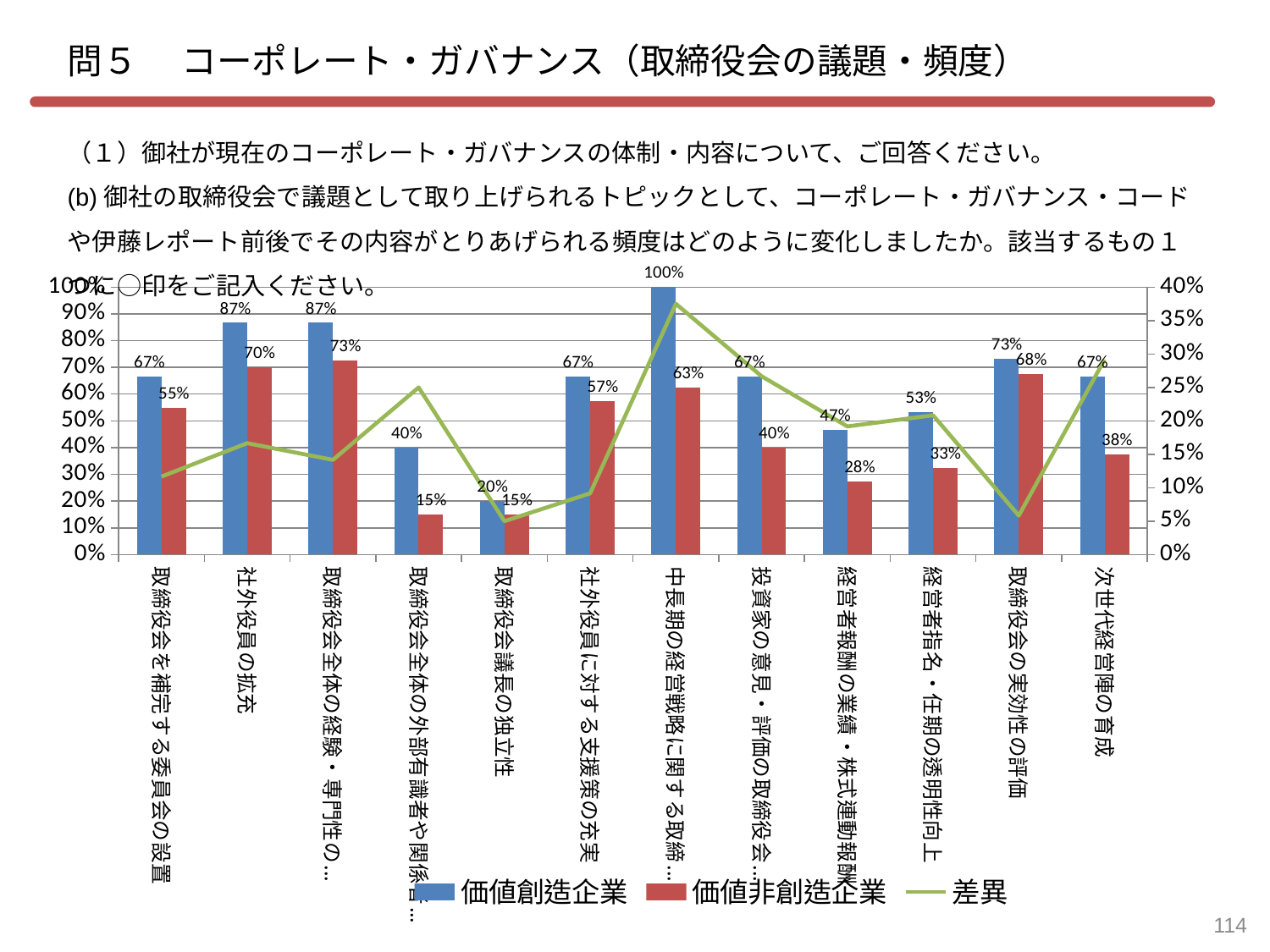
What is the difference between 価値創造企業 and 価値非創造企業 in the category 投資家の意見・評価の取締役会…? 27% How many categories are shown on the x axis of the chart? 12 Which series is drawn as a line rather than bars? 差異 What is the value for 価値創造企業 in the category 社外役員の拡充? 87% What is the value for 価値非創造企業 in the category 次世代経営陣の育成? 38% Is the 差異 value for 取締役会の実効性の評価 greater or less than 10% on the right axis? less How many series does the legend list? 3 What is the value for 価値非創造企業 in the category 経営者報酬の業績・株式連動報酬…? 28% In the category 取締役会の実効性の評価, which is larger: 価値創造企業 or 価値非創造企業? 価値創造企業 Is the 差異 value for 中長期の経営戦略に関する取締… greater or less than 30% on the right axis? greater Which category has the highest value for 価値創造企業? 中長期の経営戦略に関する取締… Which category has the lowest value for 価値創造企業? 取締役会議長の独立性